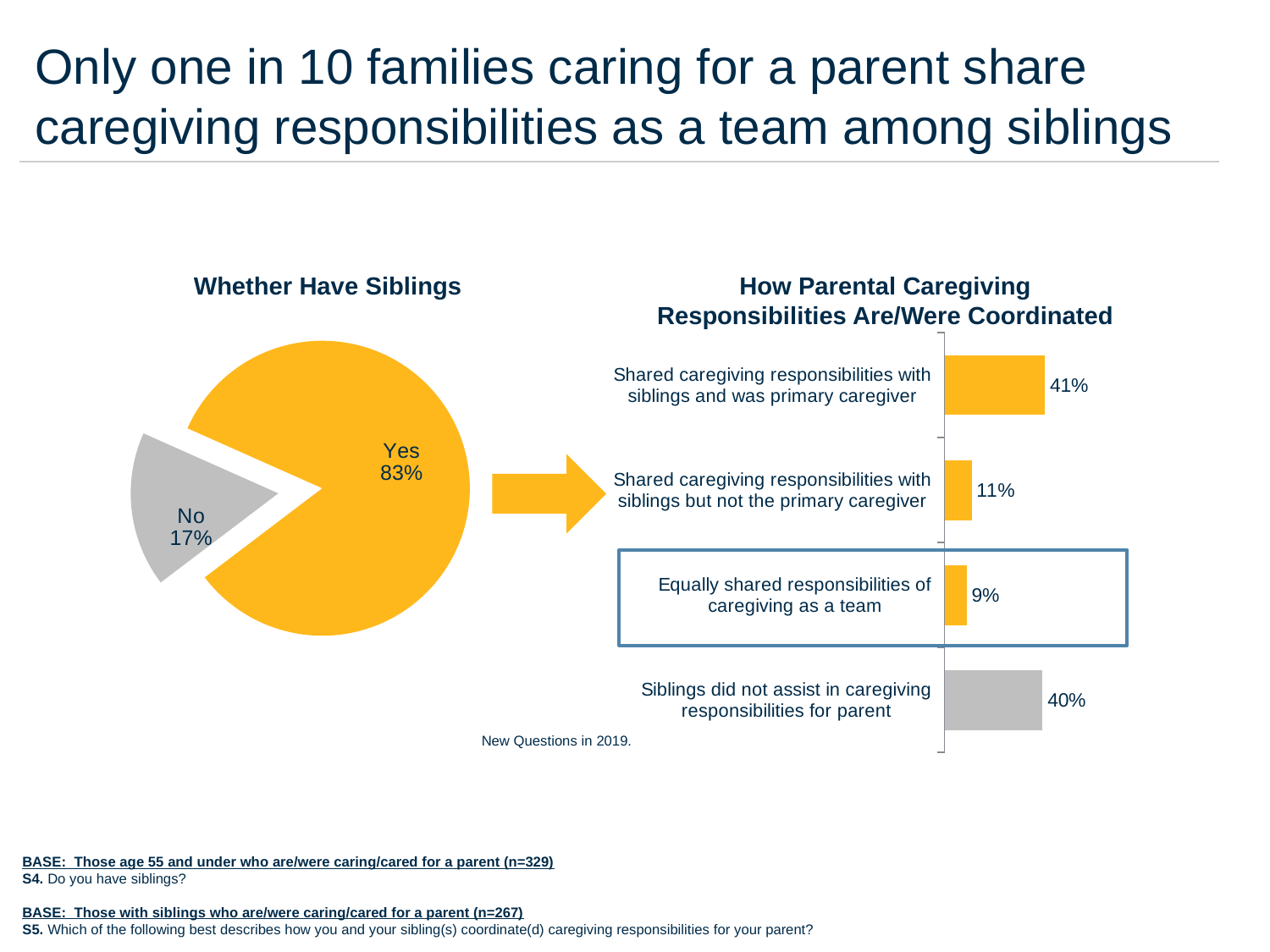
In the 'How Parental Caregiving Responsibilities Are/Were Coordinated' chart, which category has the lowest value? Equally shared responsibilities of caregiving as a team In the 'How Parental Caregiving Responsibilities Are/Were Coordinated' chart, what is the value for 'Siblings did not assist in caregiving responsibilities for parent'? 40% What kind of chart is 'Whether Have Siblings'? Pie chart In the 'Whether Have Siblings' pie chart, what percentage answered No? 17% In the 'Whether Have Siblings' pie chart, how many slices are there? 2 In the 'How Parental Caregiving Responsibilities Are/Were Coordinated' chart, how many categories are shown? 4 In the 'How Parental Caregiving Responsibilities Are/Were Coordinated' chart, what is the difference between 'Shared caregiving responsibilities with siblings and was primary caregiver' and 'Shared caregiving responsibilities with siblings but not the primary caregiver'? 30% In the 'How Parental Caregiving Responsibilities Are/Were Coordinated' chart, which category has the highest value? Shared caregiving responsibilities with siblings and was primary caregiver What kind of chart is 'How Parental Caregiving Responsibilities Are/Were Coordinated'? Bar chart In the 'Whether Have Siblings' pie chart, what is the difference between the Yes and No shares? 66% In the 'Whether Have Siblings' pie chart, what percentage answered Yes? 83% In the 'How Parental Caregiving Responsibilities Are/Were Coordinated' chart, what is the value for 'Equally shared responsibilities of caregiving as a team'? 9%